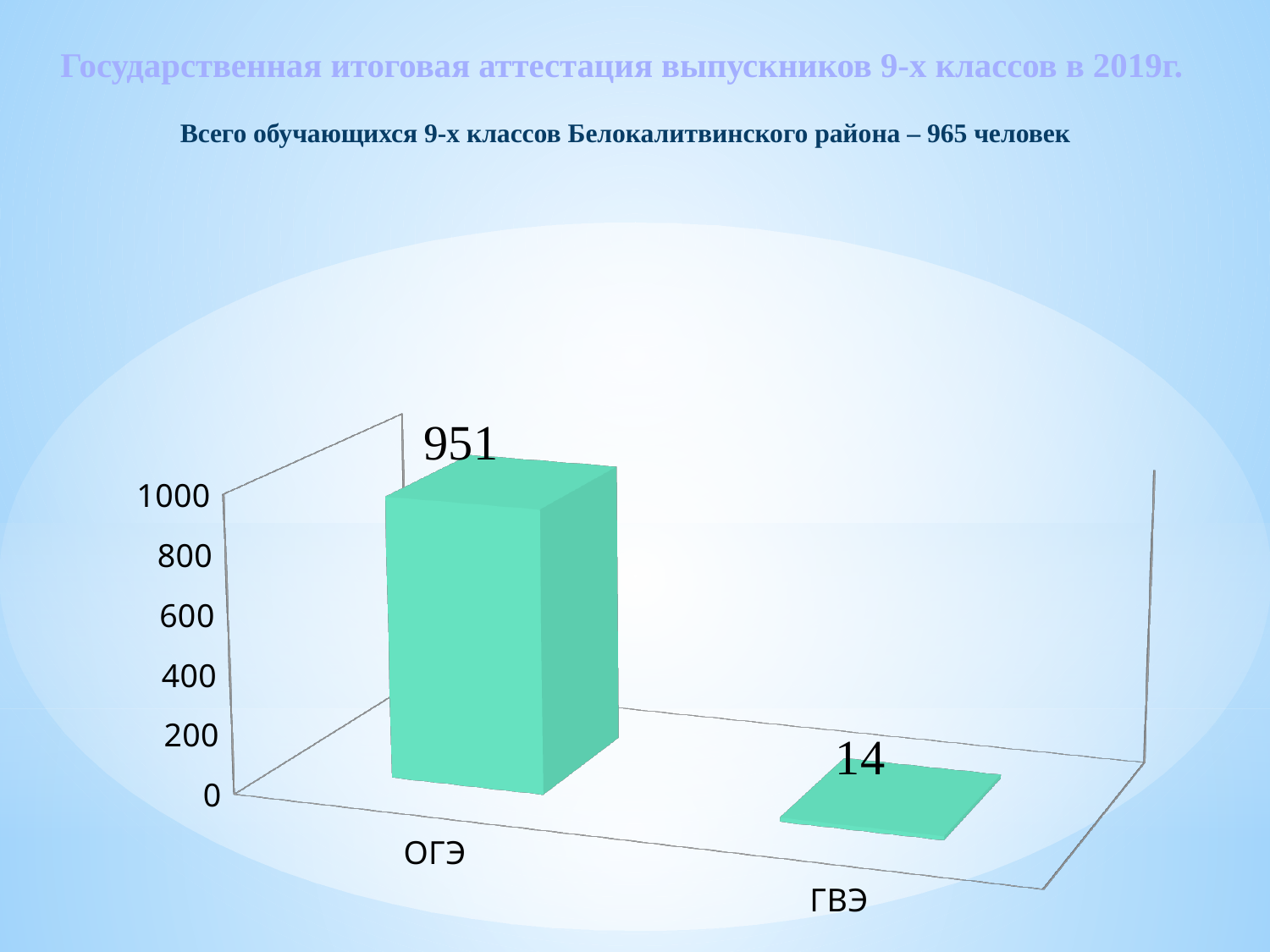
What is the total number of 9th-grade students in the Belokalitvinsky district stated on the slide? 965 человек Which category has the lowest value? ГВЭ What kind of chart is shown on the slide? bar chart How many categories are shown on the chart? 2 What is the difference between the values for ОГЭ and ГВЭ? 937 Is the value for ГВЭ greater or less than 200? less Which is larger, the value for ОГЭ or the value for ГВЭ? ОГЭ What is the highest value shown on the vertical axis? 1000 Is the value for ОГЭ greater or less than 800? greater What is the value for ОГЭ? 951 What is the value for ГВЭ? 14 Which category has the highest value? ОГЭ